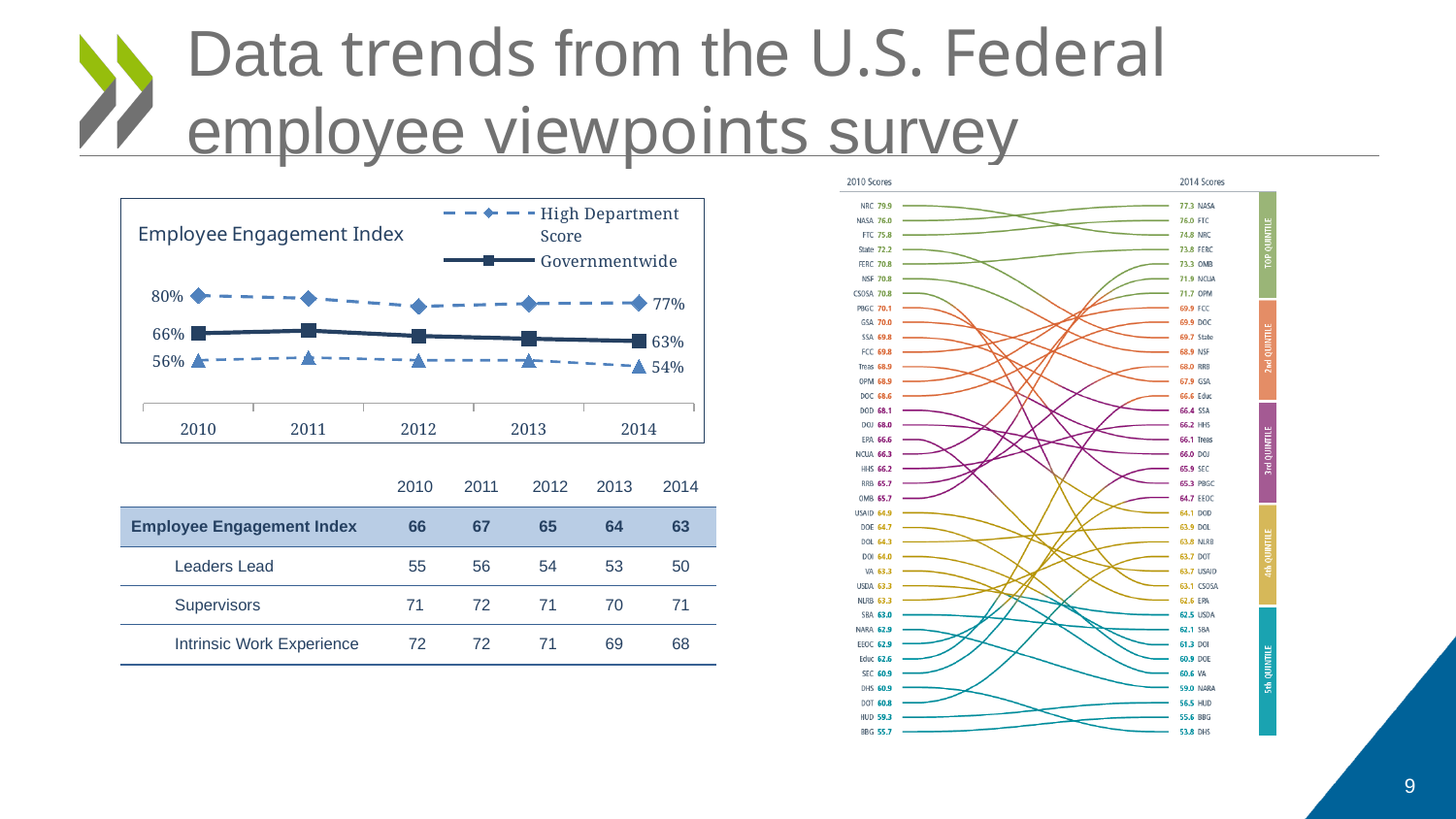
What type of chart is the Employee Engagement Index chart on the left of the slide? Line chart How many years are shown on the x axis of the Employee Engagement Index chart? 5 In the chart on the right of the slide, which agency has the highest 2010 score? NRC In the Employee Engagement Index chart, what is the Governmentwide value for 2010? 66% In the Employee Engagement Index chart, does the Governmentwide line rise or fall from 2010 to 2014? Falls In the Employee Engagement Index chart, which is larger in 2014: the High Department Score or the Governmentwide value? High Department Score In the Employee Engagement Index chart, what is the High Department Score value for 2014? 77% In the Employee Engagement Index chart, by how many percentage points did the Governmentwide value change from 2010 to 2014? 3 percentage points In the Employee Engagement Index chart, what is the High Department Score value for 2010? 80% In the Employee Engagement Index chart, what is the Governmentwide value for 2014? 63% In the chart on the right of the slide, what is the 2014 score for NASA? 77.3 What is the title of the line chart on the left of the slide? Employee Engagement Index